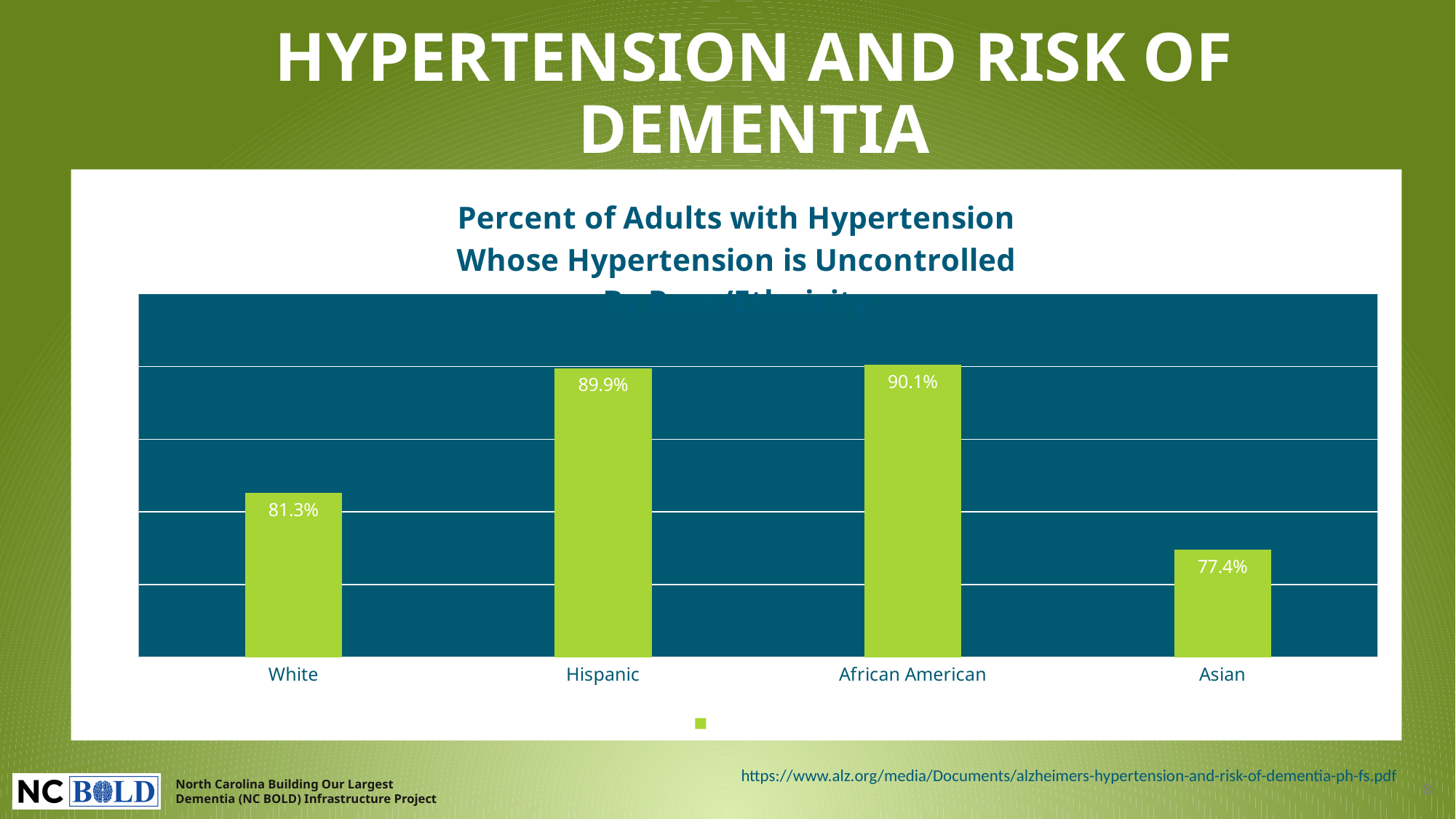
How many categories are shown on the x axis? 4 What is the value for White? 81.3% What is the value for Asian? 77.4% Which is larger, the value for White or the value for Asian? White What colour are the bars? Green Which category has the highest value? African American What kind of chart is shown? Bar chart What is the value for African American? 90.1% What is the difference between the values for White and Asian? 3.9% What is the difference between the values for African American and Hispanic? 0.2% What is the value for Hispanic? 89.9% Which category has the lowest value? Asian